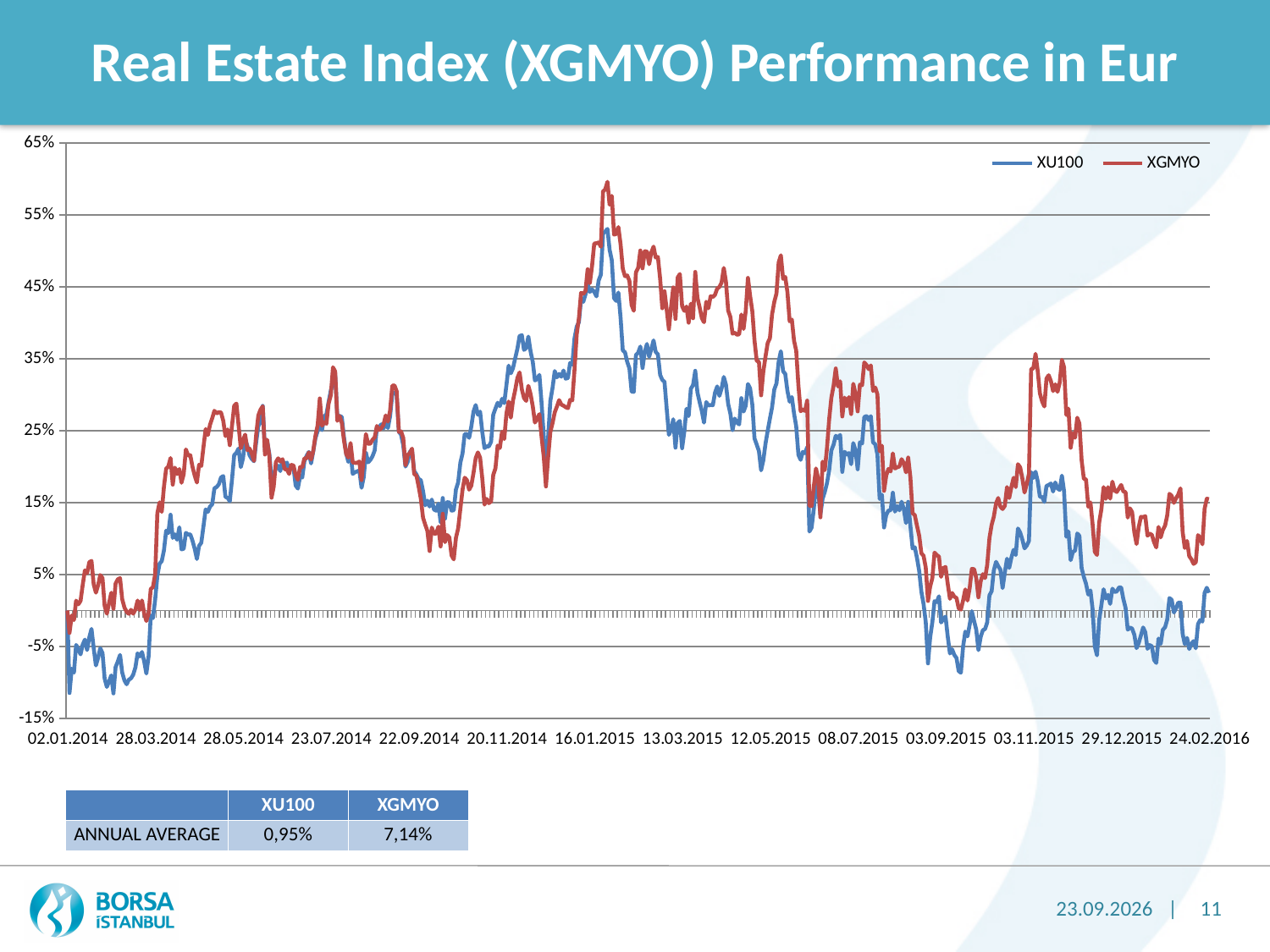
Is the value of XU100 at the start of the chart (02.01.2014) greater or less than -5%? greater Which series is higher at the end of the chart, XU100 or XGMYO? XGMYO According to the table below the chart, what is the annual average for XU100? 0,95% Which series reaches the higher peak value over the whole period? XGMYO According to the table below the chart, what is the annual average for XGMYO? 7,14% Is the peak value of the XGMYO series in early 2015 greater or less than 55%? greater What is the title of the chart on the slide? Real Estate Index (XGMYO) Performance in Eur Which colour is used for the XGMYO series in the chart? red How many series does the chart legend list? 2 What kind of chart is shown on the slide? line chart Is the value of XGMYO at the end of the chart (24.02.2016) greater or less than 5%? greater